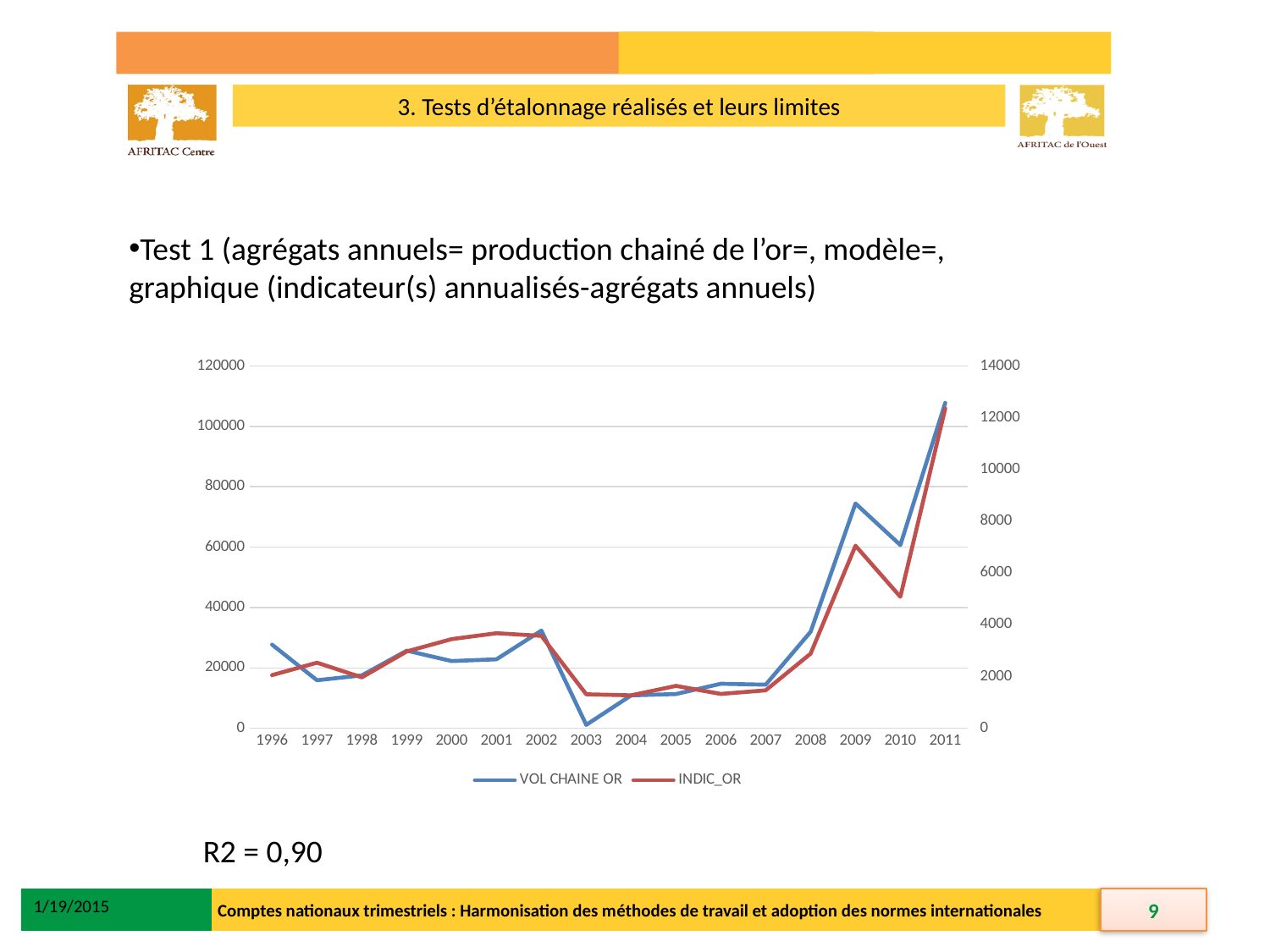
In which year does INDIC_OR reach its highest value? 2011 What are the names of the two series in the legend? VOL CHAINE OR and INDIC_OR Which is larger for VOL CHAINE OR, the value in 2009 or the value in 2010? 2009 Is the value of INDIC_OR in 2010 greater or less than 6000? less Is the value of VOL CHAINE OR in 2011 greater or less than 100000? greater How many series does the chart legend list? 2 How many years are shown on the x axis of the chart? 16 What kind of chart is shown on the slide? line chart In which year does VOL CHAINE OR reach its lowest value? 2003 Does VOL CHAINE OR rise or fall from 2009 to 2010? fall Is the value of VOL CHAINE OR in 2009 greater or less than 60000? greater In which year does VOL CHAINE OR reach its highest value? 2011